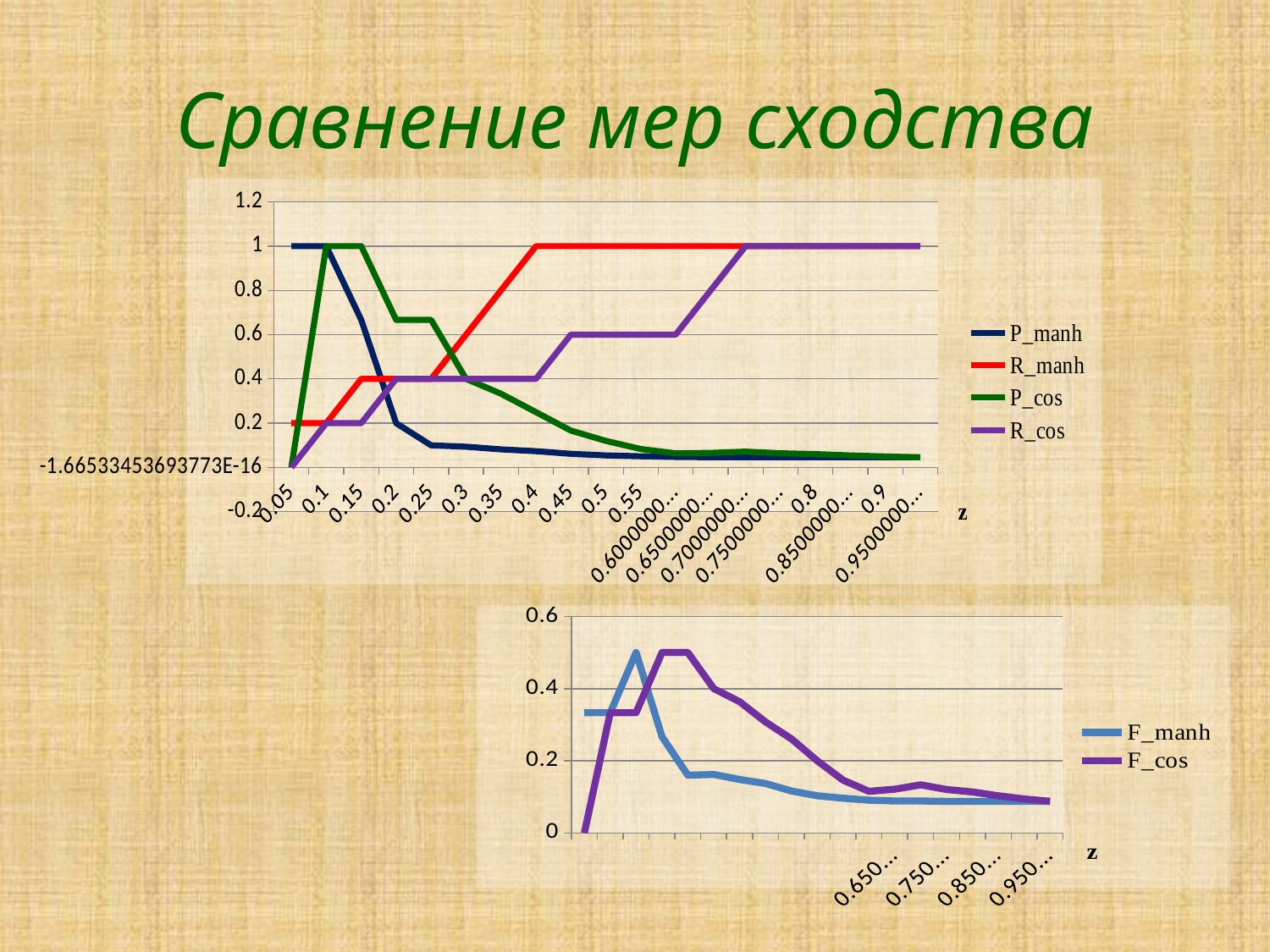
In the top chart, is the value of P_manh at z = 0.15 greater or less than 0.4? greater In the top chart, what is the value of P_manh at z = 0.05? 1 In the bottom chart, is the value of F_cos at z = 0.650... greater or less than 0.2? less What kind of chart is the top chart on the slide? line chart In the top chart, does the R_manh series rise or fall as z increases? rises In the top chart, what is the value of R_manh at z = 0.4? 1 How many series does the legend of the bottom chart list? 2 In the top chart, at z = 0.3, which series has the larger value: R_manh or P_cos? R_manh In the top chart, what is the value of R_cos at z = 0.45? 0.6 In the top chart, does the P_manh series rise or fall as z increases? falls In the top chart, is the value of P_cos at z = 0.2 greater or less than 0.6? greater How many series does the legend of the top chart list? 4